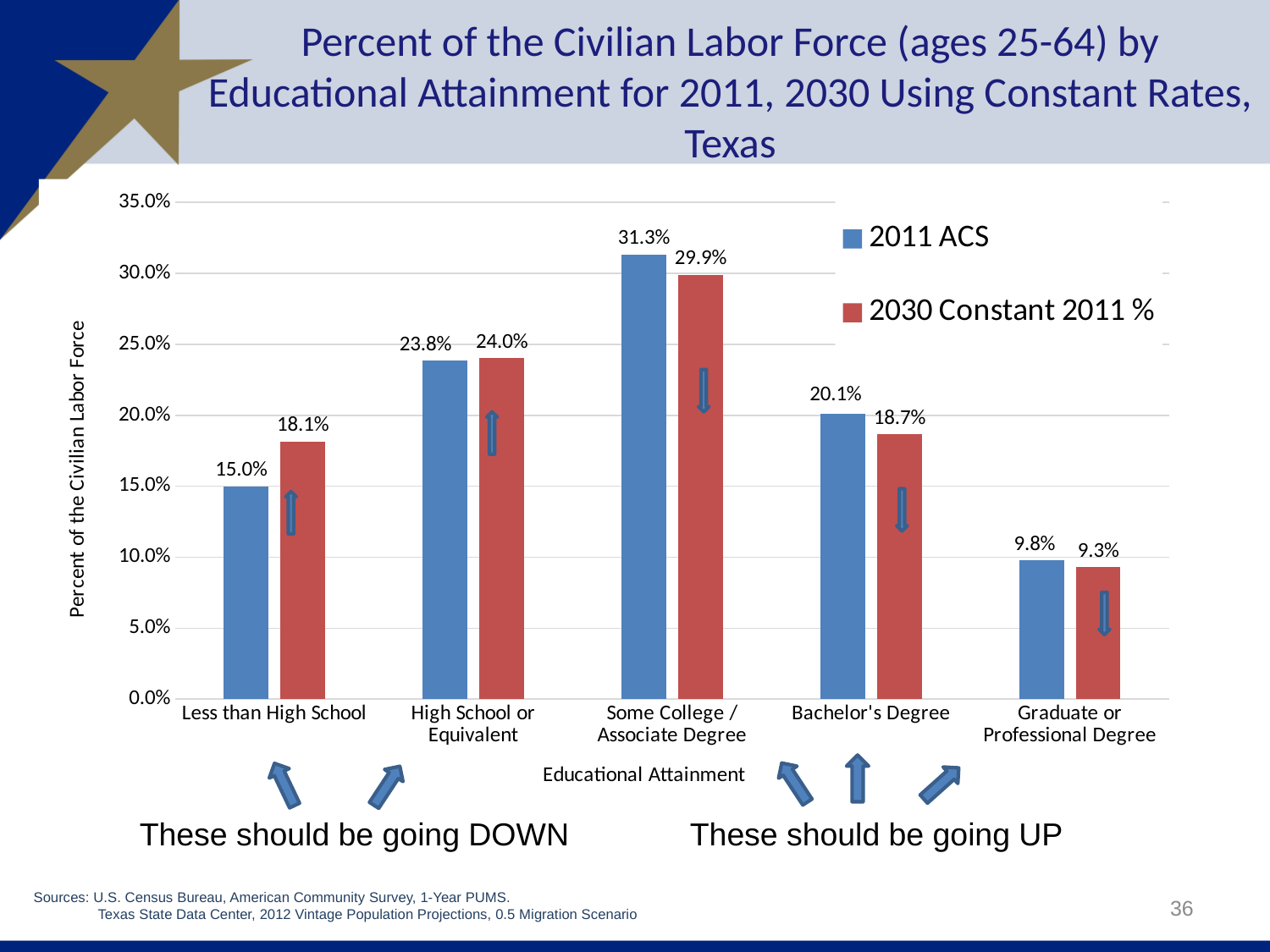
How many series does the legend list? 2 For Bachelor's Degree, which series has the larger value, 2011 ACS or 2030 Constant 2011 %? 2011 ACS What is the 2011 ACS value for Less than High School? 15.0% Which educational attainment category has the highest 2011 ACS value? Some College / Associate Degree How many educational attainment categories are shown on the x axis? 5 What is the 2011 ACS value for Some College / Associate Degree? 31.3% Which educational attainment category has the lowest 2030 Constant 2011 % value? Graduate or Professional Degree What is the difference between the 2030 Constant 2011 % and 2011 ACS values for Less than High School? 3.1% What is the label of the y axis? Percent of the Civilian Labor Force What is the difference between the 2011 ACS and 2030 Constant 2011 % values for Some College / Associate Degree? 1.4% What is the 2030 Constant 2011 % value for Bachelor's Degree? 18.7% What kind of chart is shown on the slide? Bar chart